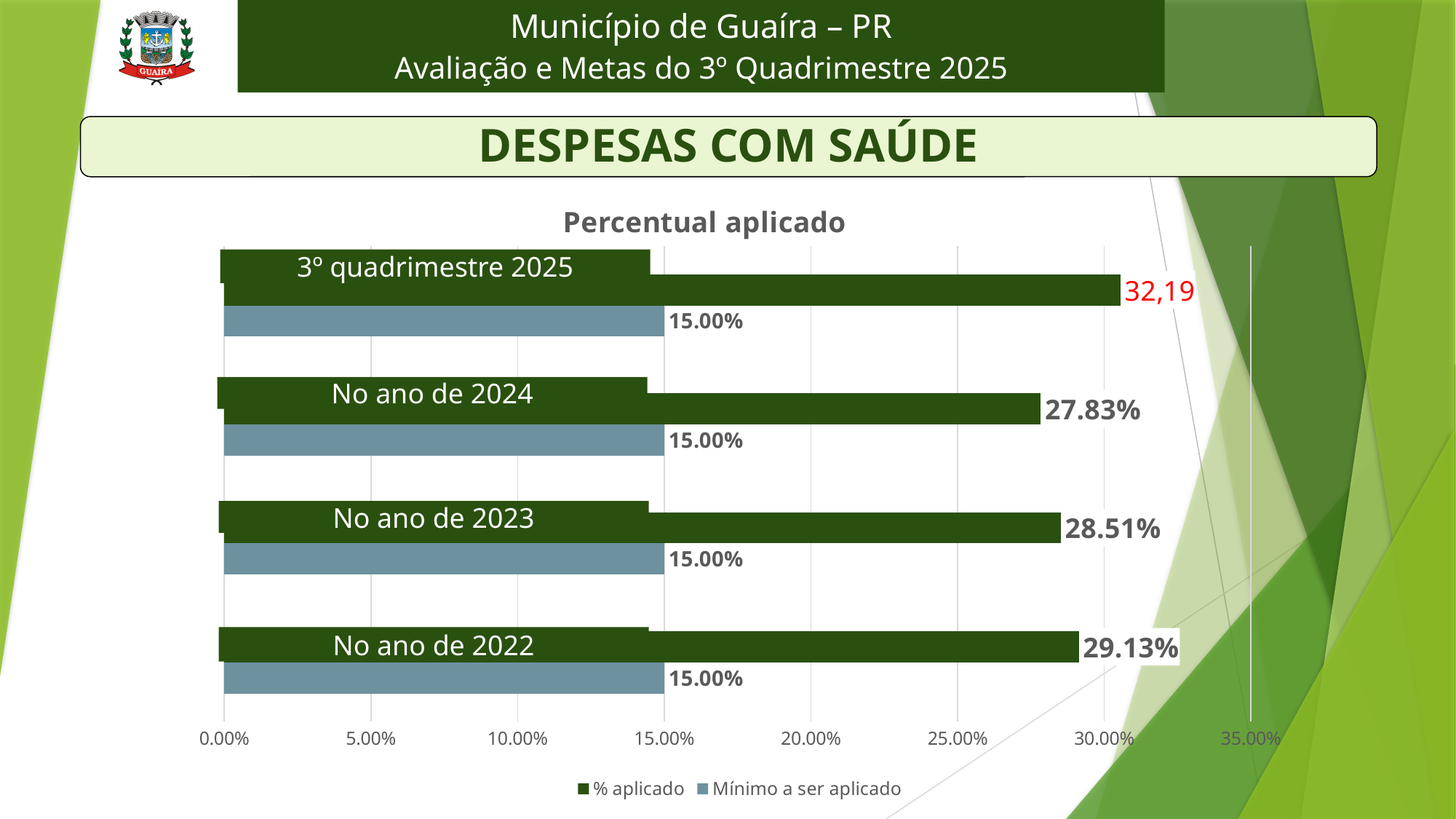
How many categories are shown on the chart? 4 What is the value of '% aplicado' for 'No ano de 2022'? 29.13% How many series does the legend list? 2 What is the value of 'Mínimo a ser aplicado' for 'No ano de 2023'? 15.00% Which category has the highest '% aplicado' value? 3º quadrimestre 2025 What is the difference between '% aplicado' and 'Mínimo a ser aplicado' for 'No ano de 2022'? 14.13% What value is labelled on the '% aplicado' bar for '3º quadrimestre 2025'? 32,19 What is the value of '% aplicado' for 'No ano de 2024'? 27.83% What type of chart is shown on the slide? Bar chart What is the title of the chart? Percentual aplicado What is the value of '% aplicado' for 'No ano de 2023'? 28.51% Which category has the lowest '% aplicado' value? No ano de 2024